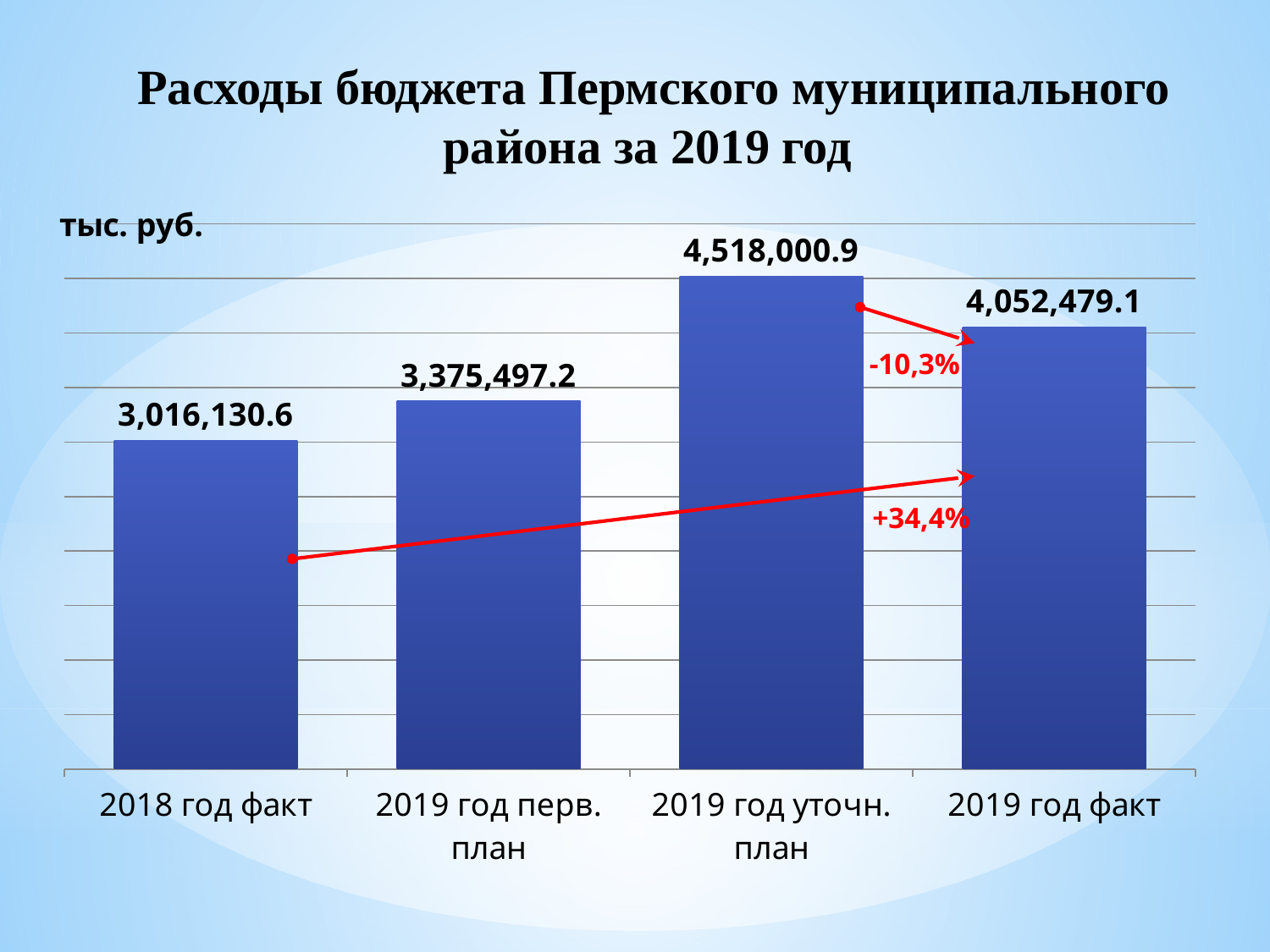
What is the value for 2019 год уточн. план? 4,518,000.9 Which is larger, 2019 год перв. план or 2019 год факт? 2019 год факт What is the difference between 2019 год уточн. план and 2019 год факт? 465,521.8 What unit of measurement is indicated above the chart? тыс. руб. Which category has the lowest value? 2018 год факт What is the value for 2019 год перв. план? 3,375,497.2 How many categories are shown in the chart? 4 What is the value for 2019 год факт? 4,052,479.1 What kind of chart is shown on the slide? Bar chart Which category has the highest value? 2019 год уточн. план What is the difference between 2019 год факт and 2018 год факт? 1,036,348.5 What is the value for 2018 год факт? 3,016,130.6